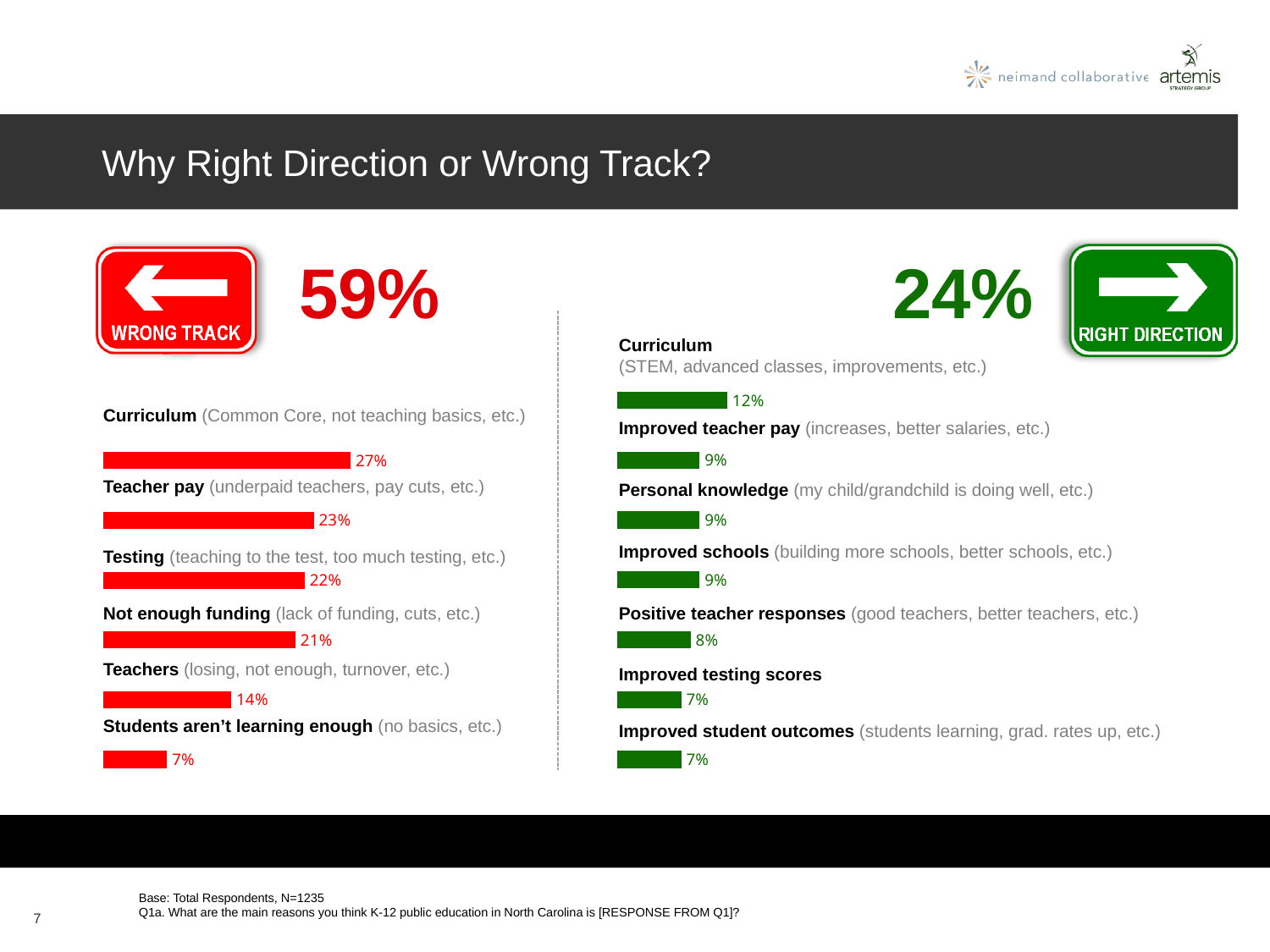
What kind of chart is used on the Wrong Track side (left)? Bar chart On the Wrong Track chart (left), which reason has the lowest percentage? Students aren't learning enough On the Right Direction chart (right), what percentage is shown for Positive teacher responses? 8% How many reasons are listed on the Right Direction chart (right)? 7 On the Right Direction chart (right), which reason has the highest percentage? Curriculum On the Wrong Track chart (left), which reason has the highest percentage? Curriculum On the Wrong Track chart (left), which is larger: Testing or Not enough funding? Testing On the Wrong Track chart (left), what is the difference between the Curriculum and Teachers percentages? 13% On the Right Direction chart (right), what is the difference between the Curriculum and Improved testing scores percentages? 5% On the Wrong Track chart (left), what percentage is shown for Teacher pay? 23% On the Wrong Track chart (left), what percentage is shown for Curriculum? 27% On the Right Direction chart (right), what percentage is shown for Curriculum? 12%